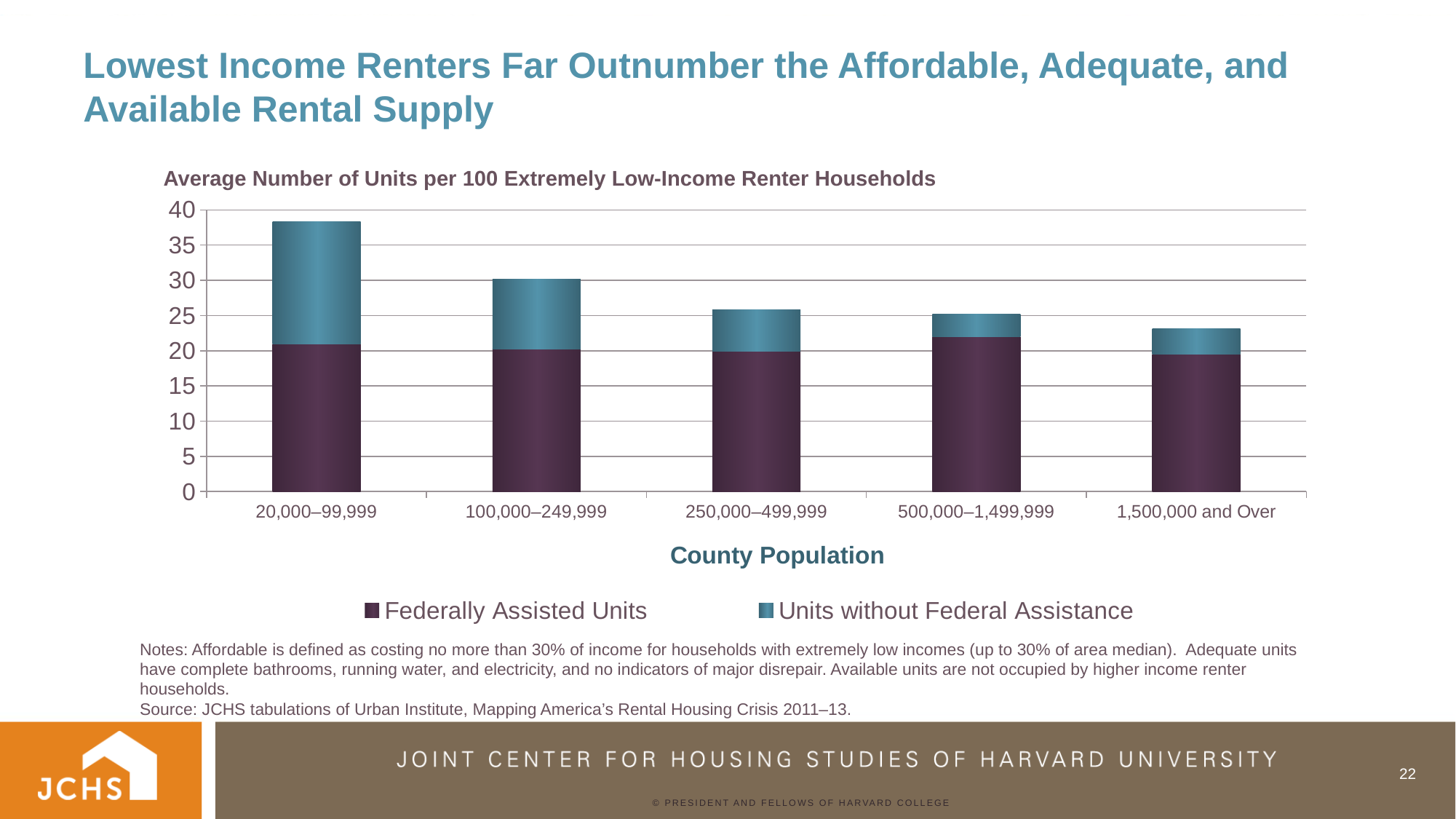
Is the total bar for the 20,000–99,999 category greater or less than 35? greater Which county population category has the lowest total number of units per 100 extremely low-income renter households? 1,500,000 and Over Which county population category has the highest total number of units per 100 extremely low-income renter households? 20,000–99,999 Which has a larger total bar: 20,000–99,999 or 100,000–249,999? 20,000–99,999 Do the total bar heights rise or fall as county population increases along the x axis? fall Is the Federally Assisted Units value for the 500,000–1,499,999 category greater or less than 20? greater How many county population categories are shown on the x axis? 5 How many series does the legend list? 2 What kind of chart is shown on the slide? Stacked bar chart Is the total bar for the 250,000–499,999 category greater or less than 30? less What is the title of the x axis? County Population